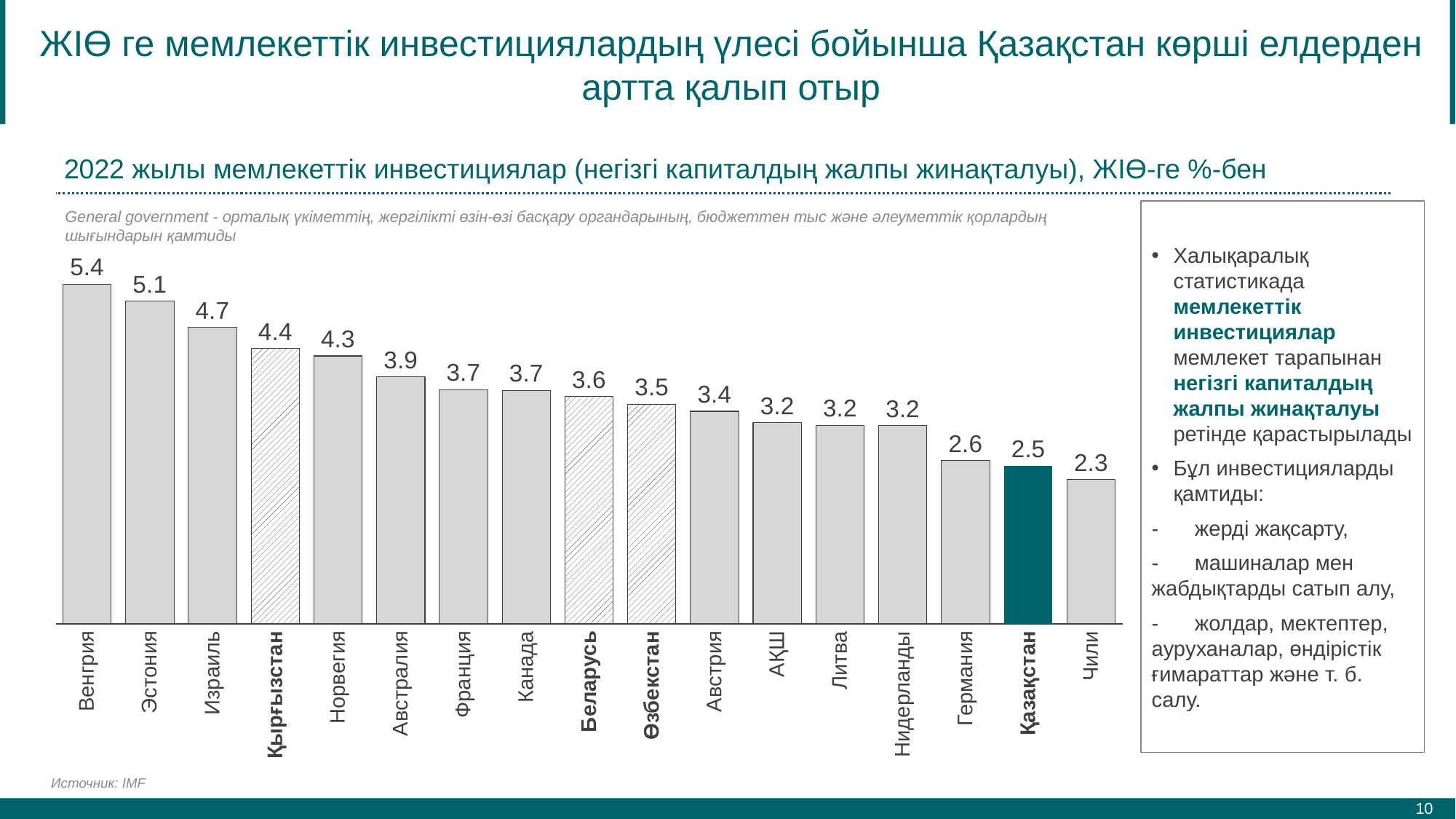
What is the difference between the values for Беларусь and Қазақстан? 1.1 What is the value shown for Қазақстан? 2.5 What kind of chart is shown on the slide? Bar chart What is the value shown for Қырғызстан? 4.4 Which country has the highest value in the chart? Венгрия Which has a larger value, Норвегия or Германия? Норвегия Which country has the lowest value in the chart? Чили What is the value shown for Венгрия? 5.4 Do the values rise or fall from left to right along the x axis? Fall How many countries are shown in the chart? 17 What is the difference between the values for Венгрия and Қазақстан? 2.9 What is the value shown for Өзбекстан? 3.5